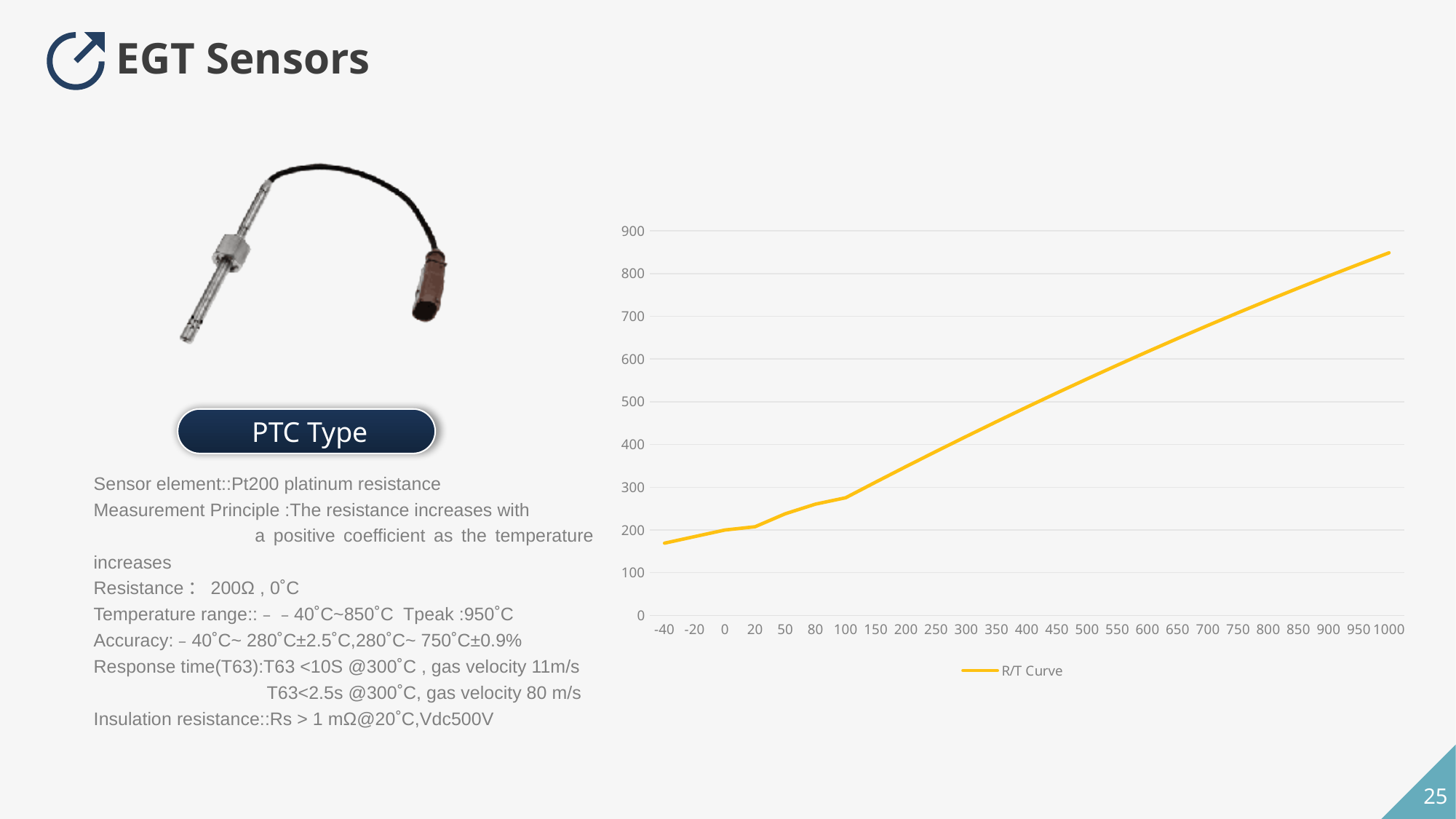
At which x-axis category is the R/T Curve value lowest? -40 What is the name of the series shown in the chart legend? R/T Curve At which x-axis category is the R/T Curve value highest? 1000 Is the R/T Curve value at 100 greater or less than 300? less Do the values of the R/T Curve rise or fall as the x axis increases? rise Which has the larger R/T Curve value, the point at 1000 or the point at -40? 1000 What kind of chart is shown on the slide? line chart How many series does the chart legend list? 1 Is the R/T Curve value at 1000 greater or less than 800? greater How many x-axis categories are plotted on the chart? 25 Is the R/T Curve value at 700 greater or less than 600? greater